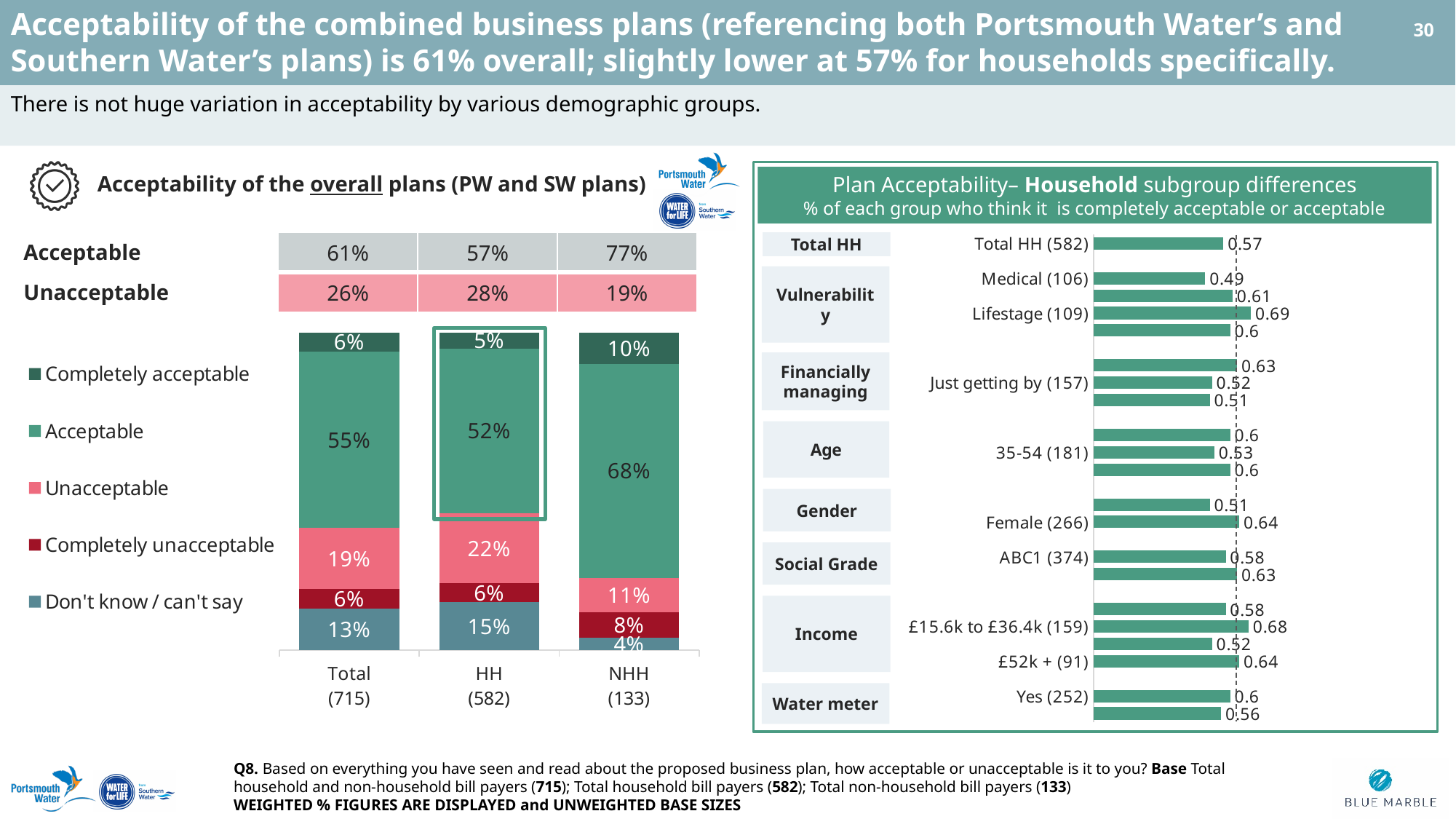
In the stacked bar chart on the left, which is larger: the Completely unacceptable share for Total (715) or for NHH (133)? NHH (133) In the 'Plan Acceptability – Household subgroup differences' chart, what is the value for Medical (106)? 0.49 In the stacked bar chart on the left, which group has the highest Completely acceptable percentage? NHH (133) In the stacked bar chart on the left, what percentage of NHH (133) respondents said the plans were Acceptable? 68% What kind of chart is the left-hand chart titled 'Acceptability of the overall plans (PW and SW plans)'? Stacked bar chart In the 'Plan Acceptability – Household subgroup differences' chart, which is larger: the value for Female (266) or for 35-54 (181)? Female (266) In the 'Plan Acceptability – Household subgroup differences' chart, what is the value for Total HH (582)? 0.57 In the stacked bar chart on the left, what is the difference between the Unacceptable percentage for HH (582) and for NHH (133)? 11 percentage points In the stacked bar chart on the left, what is the Don't know / can't say value for HH (582)? 15% How many groups are shown along the x axis of the left-hand stacked bar chart? 3 In the 'Plan Acceptability – Household subgroup differences' chart, what is the value for Lifestage (109)? 0.69 How many series does the legend of the left-hand stacked bar chart list? 5